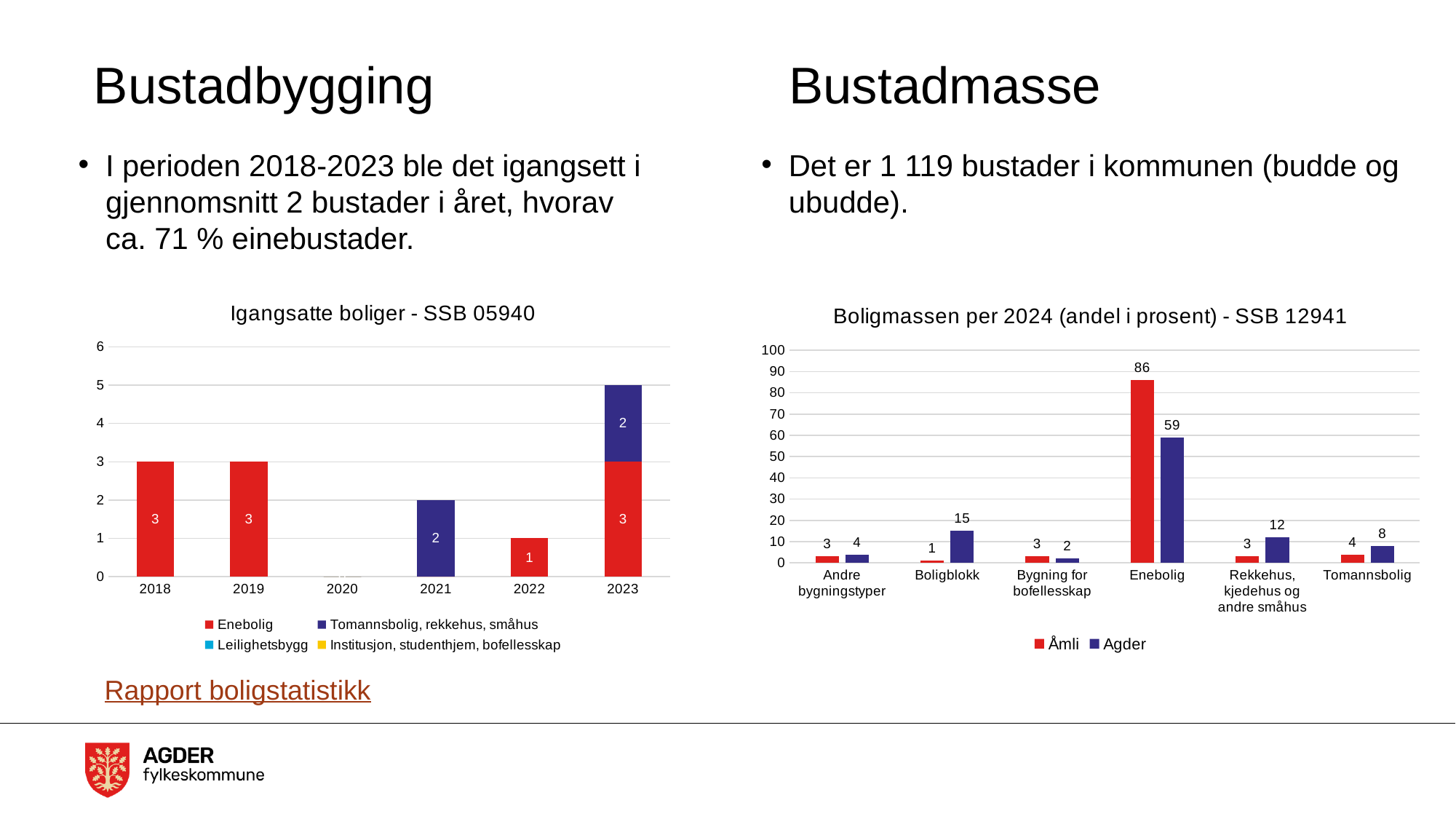
In the chart 'Igangsatte boliger - SSB 05940', what is the value for Enebolig in 2018? 3 In the chart 'Igangsatte boliger - SSB 05940', how many series does the legend list? 4 In the chart 'Igangsatte boliger - SSB 05940', what is the total height of the stacked bar for 2023? 5 In the chart 'Boligmassen per 2024 (andel i prosent) - SSB 12941', which is larger in the Rekkehus, kjedehus og andre småhus category: Åmli or Agder? Agder In the chart 'Boligmassen per 2024 (andel i prosent) - SSB 12941', which category has the highest value for Agder? Enebolig In the chart 'Boligmassen per 2024 (andel i prosent) - SSB 12941', what is the value for Agder in the Boligblokk category? 15 What kind of chart is 'Igangsatte boliger - SSB 05940'? Stacked bar chart In the chart 'Boligmassen per 2024 (andel i prosent) - SSB 12941', what is the value for Åmli in the Enebolig category? 86 In the chart 'Boligmassen per 2024 (andel i prosent) - SSB 12941', what is the difference between Åmli and Agder in the Enebolig category? 27 In the chart 'Boligmassen per 2024 (andel i prosent) - SSB 12941', how many categories are shown on the x axis? 6 In the chart 'Igangsatte boliger - SSB 05940', what is the value for Tomannsbolig, rekkehus, småhus in 2021? 2 In the chart 'Igangsatte boliger - SSB 05940', how many years are shown on the x axis? 6